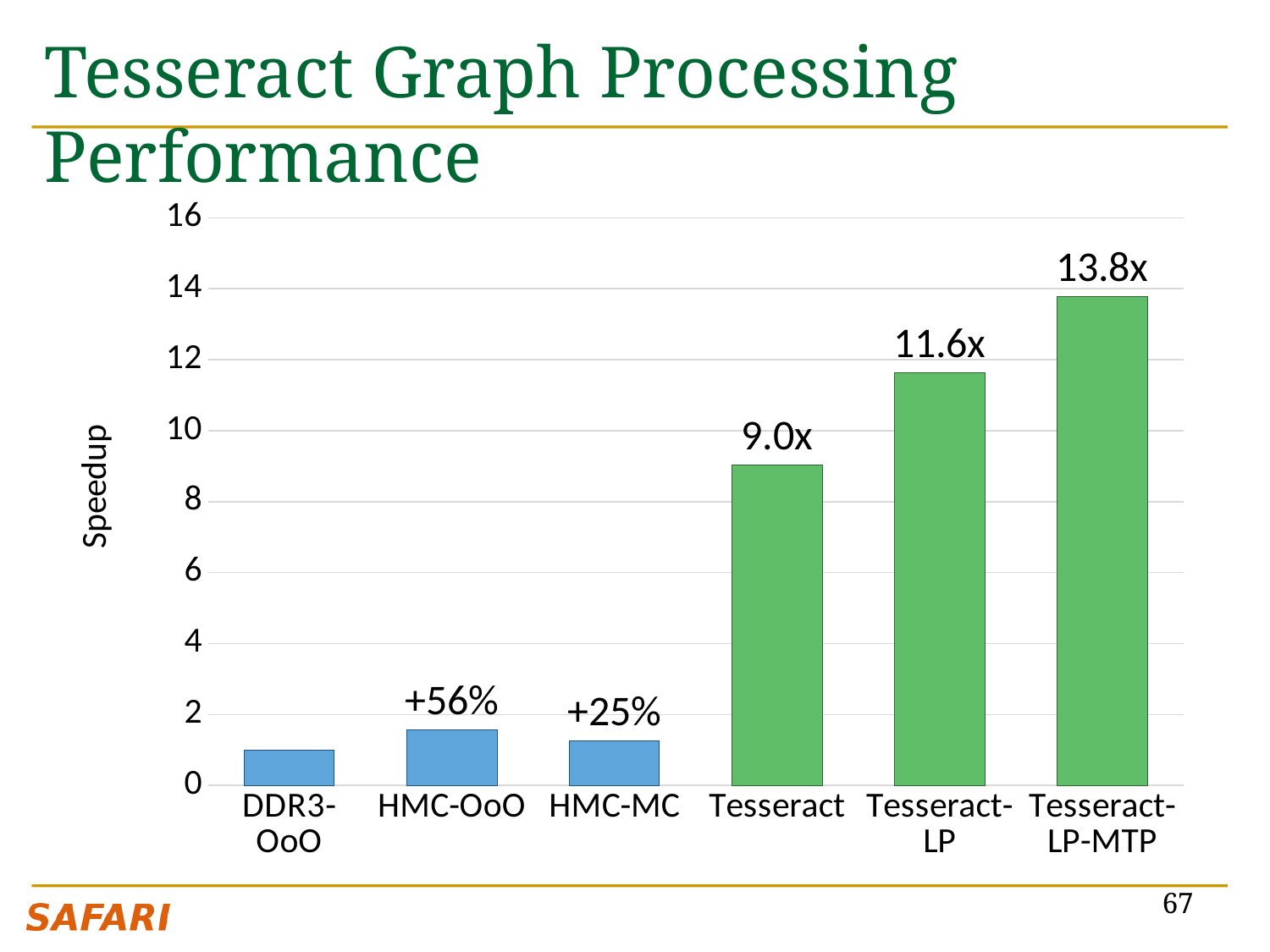
What is the data label shown for Tesseract? 9.0x What is the data label shown above the HMC-OoO bar? +56% What is the difference between the labeled speedups of Tesseract-LP-MTP and Tesseract-LP? 2.2x How many categories are shown on the x axis? 6 What is the data label shown for Tesseract-LP-MTP? 13.8x Which category has the highest speedup? Tesseract-LP-MTP What is the label of the y axis? Speedup Which category has the lowest speedup? DDR3-OoO What is the data label shown above the HMC-MC bar? +25% Is the value for DDR3-OoO greater or less than 2? less What is the data label shown for Tesseract-LP? 11.6x Which has the larger speedup, HMC-OoO or HMC-MC? HMC-OoO